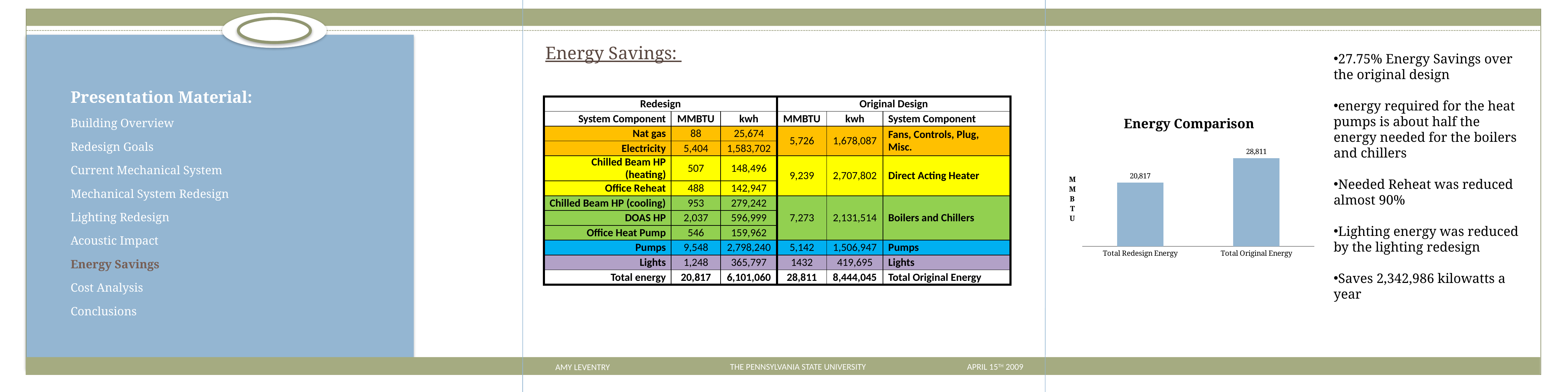
What is the value for Total Original Energy in the Energy Comparison chart? 28,811 What is the title of the chart on the slide? Energy Comparison What kind of chart is the Energy Comparison chart? Bar chart Which category has the lowest value in the Energy Comparison chart? Total Redesign Energy Which category has the highest value in the Energy Comparison chart? Total Original Energy What is the value for Total Redesign Energy in the Energy Comparison chart? 20,817 What is the difference between Total Original Energy and Total Redesign Energy in the Energy Comparison chart? 7,994 What unit is shown on the vertical axis of the Energy Comparison chart? MMBTU How many categories are shown in the Energy Comparison chart? 2 In the Energy Comparison chart, which is larger: Total Redesign Energy or Total Original Energy? Total Original Energy